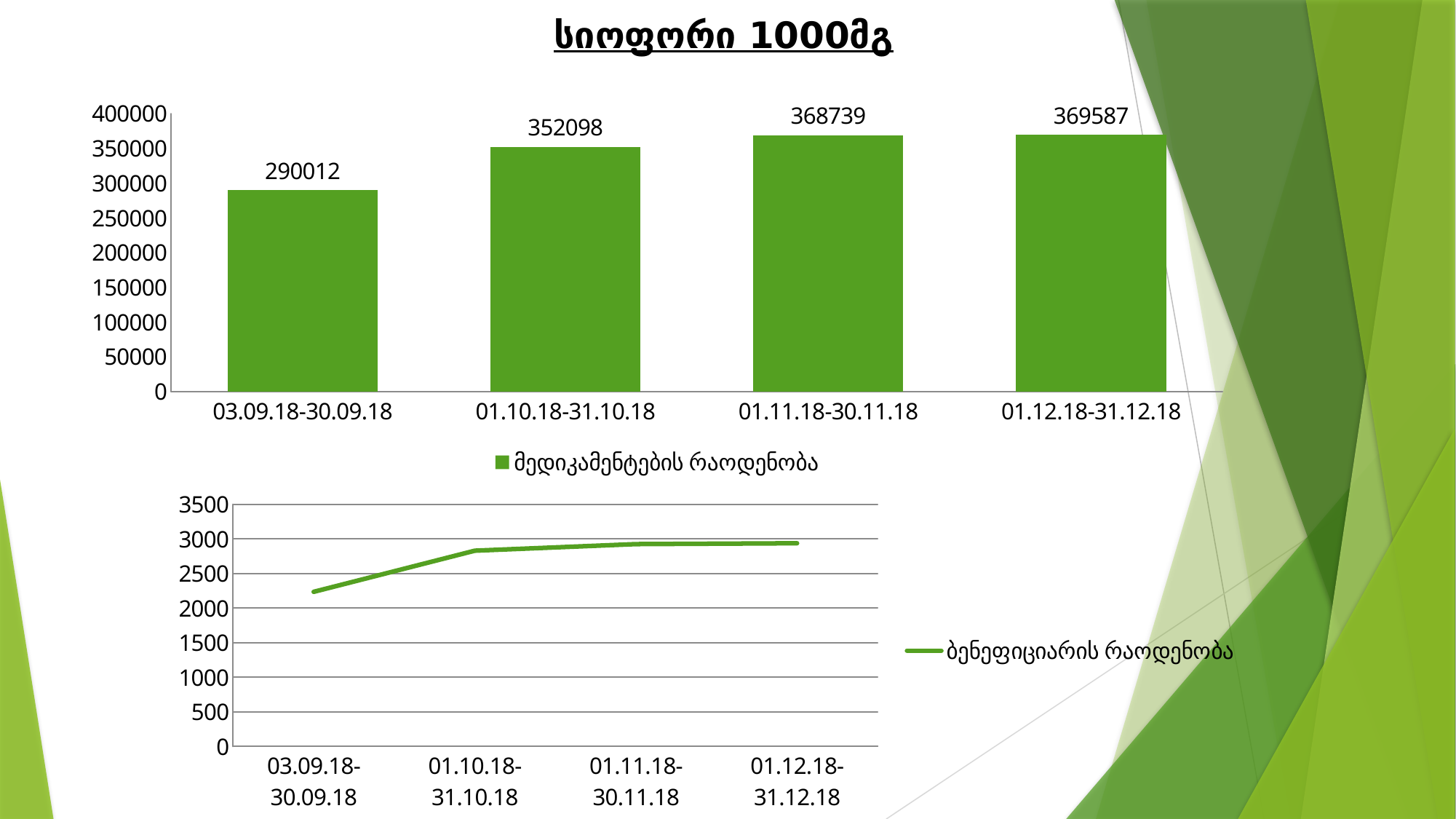
In the bottom line chart, is the value for 03.09.18-30.09.18 greater or less than 2500? less In the top bar chart, what is the value for 03.09.18-30.09.18? 290012 In the top bar chart, what is the value for 01.11.18-30.11.18? 368739 In the top bar chart, which period has the highest value? 01.12.18-31.12.18 How many bars are in the top bar chart? 4 In the bottom line chart, do the values rise or fall from left to right? rise In the bottom line chart, is the value for 01.12.18-31.12.18 greater or less than 2500? greater What kind of chart is the top chart on the slide? bar chart What kind of chart is the bottom chart on the slide? line chart In the top bar chart, which period has the lowest value? 03.09.18-30.09.18 In the top bar chart, which is larger: the value for 01.10.18-31.10.18 or 01.11.18-30.11.18? 01.11.18-30.11.18 In the top bar chart, what is the difference between the values for 01.10.18-31.10.18 and 03.09.18-30.09.18? 62086